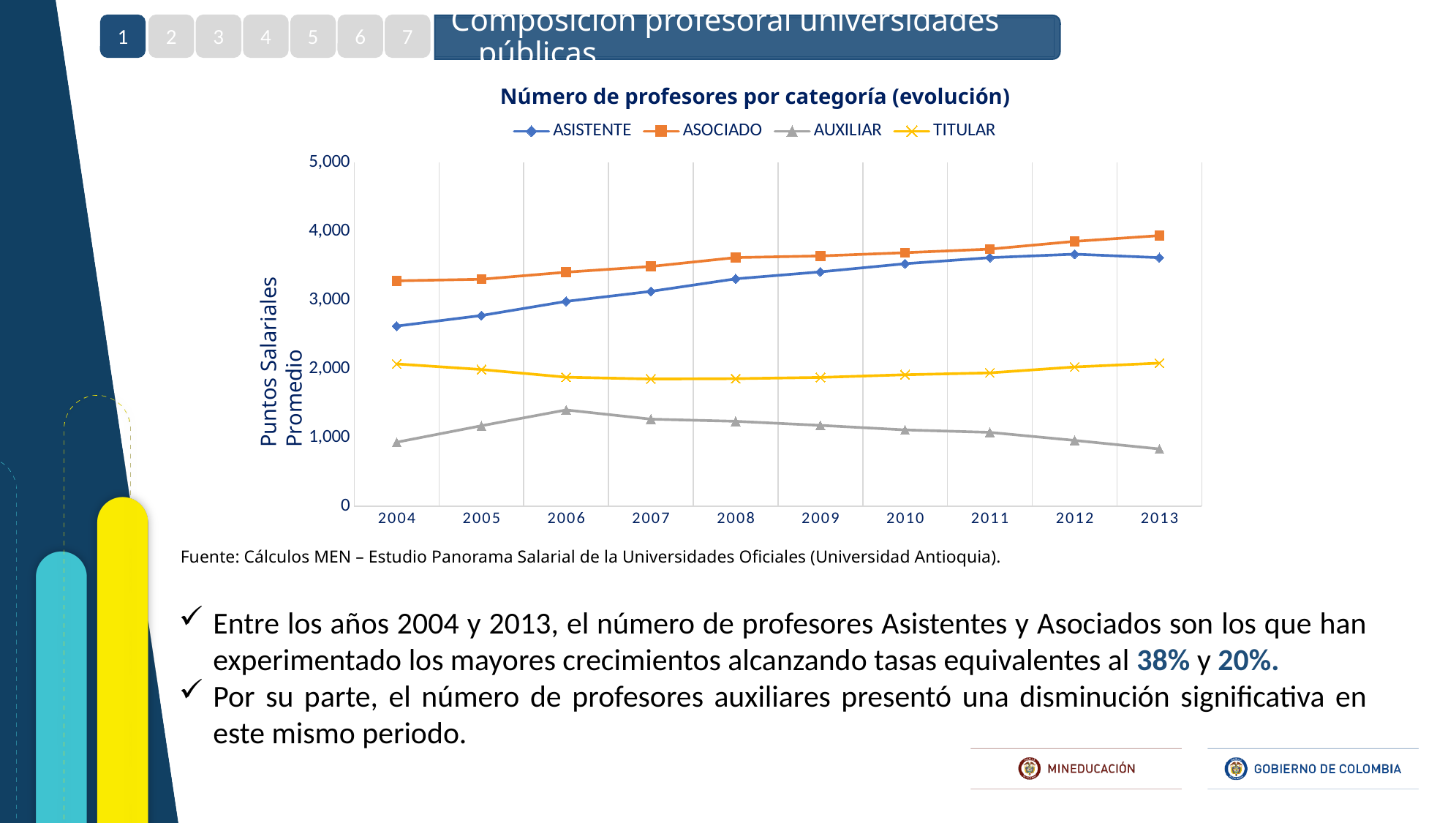
Which series has the lowest value in 2013? AUXILIAR What is the title of the chart? Número de profesores por categoría (evolución) Is the value for ASISTENTE in 2004 greater or less than 2,000? greater How many years are shown on the x axis? 10 Does the AUXILIAR series rise or fall from 2006 to 2013? Falls Is the value for TITULAR in 2006 greater or less than 2,000? less What kind of chart is shown on the slide? Line chart Is the value for AUXILIAR in 2013 greater or less than 1,000? less Which series has the highest value in 2013? ASOCIADO Does the ASOCIADO series rise or fall from 2004 to 2013? Rises How many series does the legend list? 4 In 2010, which is larger: ASISTENTE or TITULAR? ASISTENTE